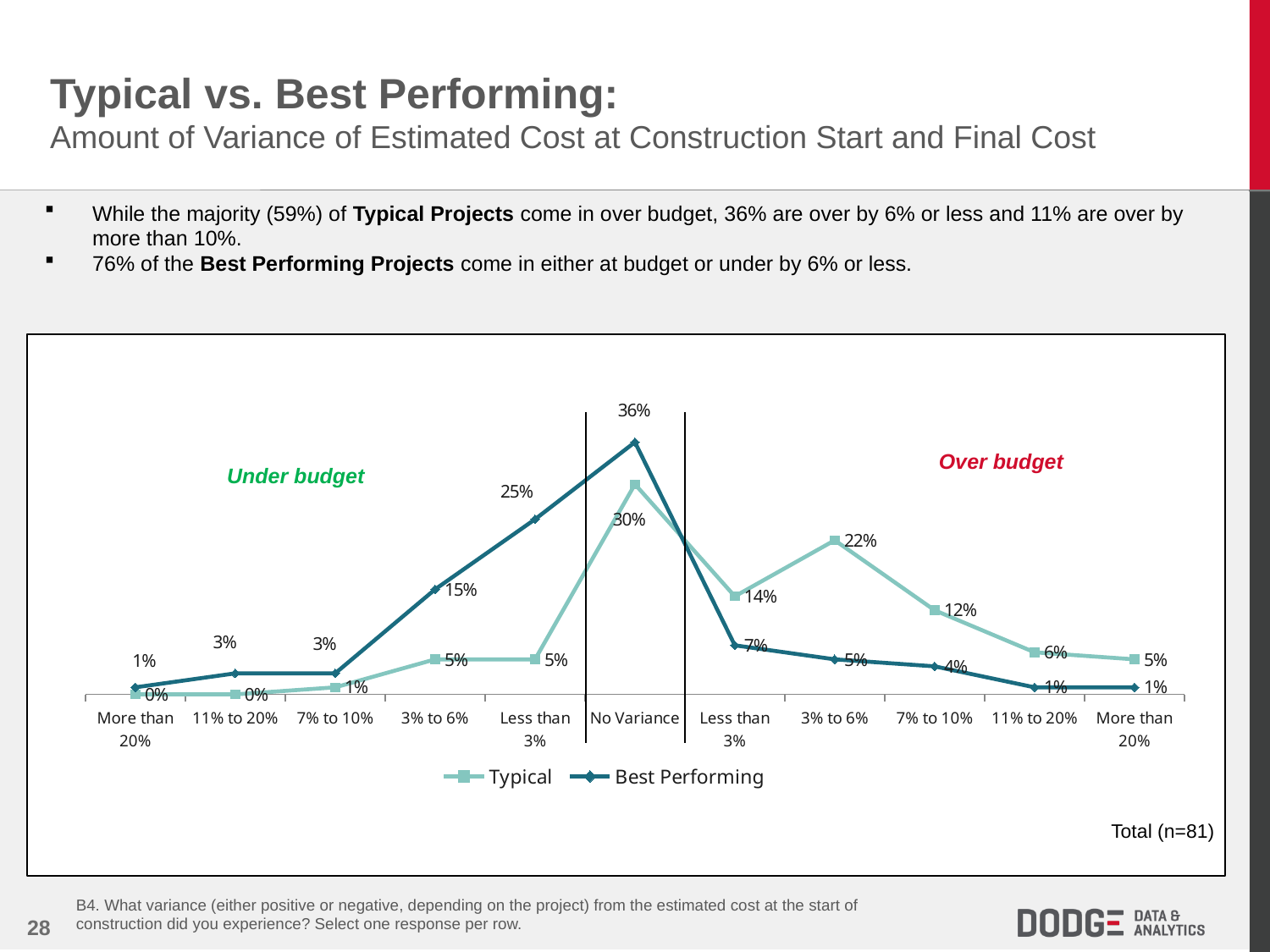
What is the value for Best Performing projects in the Less than 3% under budget category? 25% What is the value for Typical projects at No Variance? 30% How many categories are shown along the x axis? 11 At No Variance, how many percentage points higher is Best Performing than Typical? 6 percentage points What kind of chart is shown on the slide? Line chart In which category does the Best Performing series reach its highest value? No Variance What is the value for Best Performing projects at No Variance? 36% What is the value for Typical projects in the 3% to 6% over budget category? 22% What is the value for Typical projects in the More than 20% over budget category? 5% What sample size (n) is noted on the chart? n=81 How many series does the chart legend list? 2 In the 3% to 6% over budget category, which series has the larger value, Typical or Best Performing? Typical